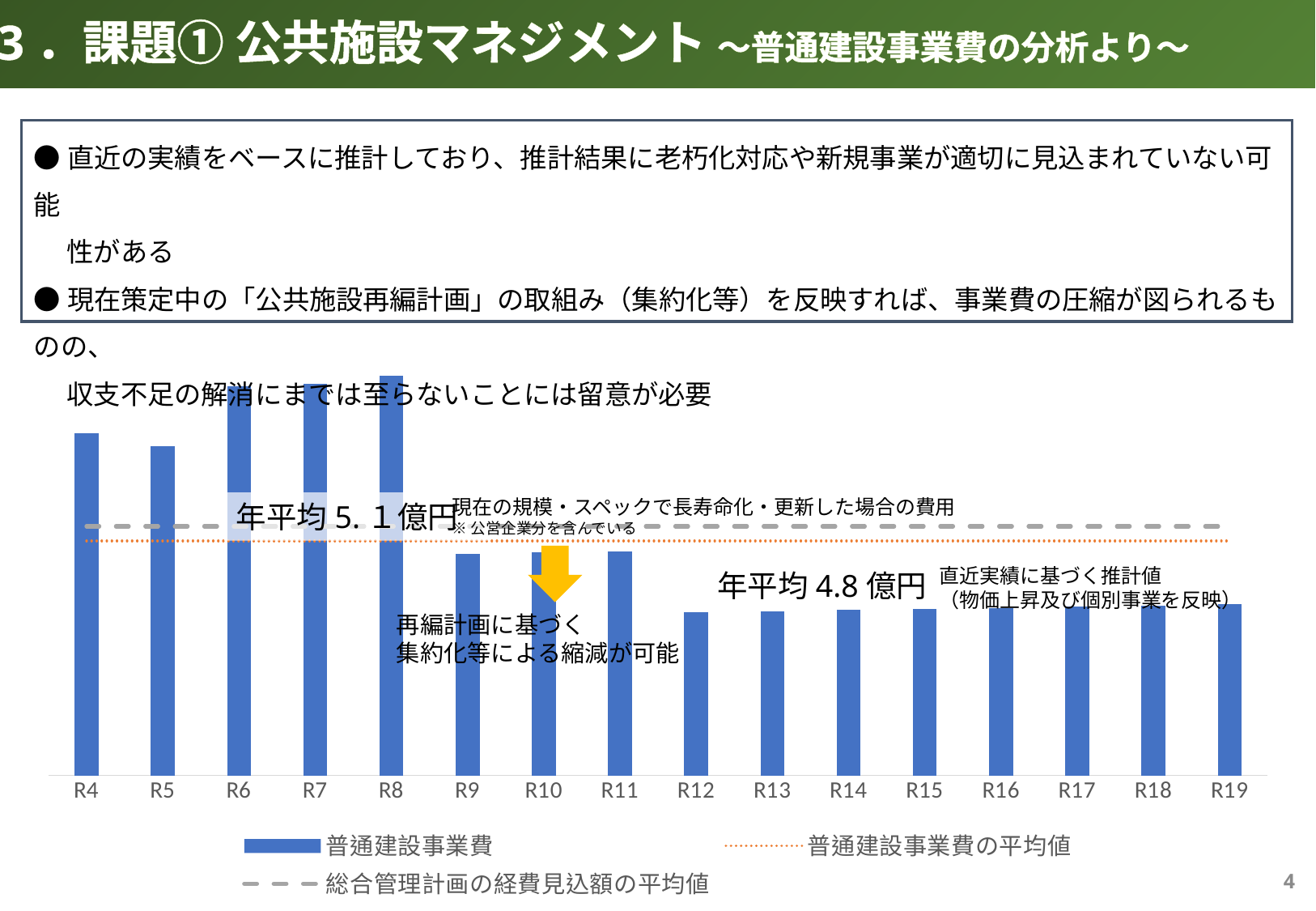
Which is larger, the bar for R9 or the bar for R12? R9 Which average line is higher, 総合管理計画の経費見込額の平均値 or 普通建設事業費の平均値? 総合管理計画の経費見込額の平均値 What annual average value is labelled for 総合管理計画の経費見込額の平均値 (the dashed line)? 5.1億円 How many categories (fiscal years) are shown on the x axis of the chart? 16 How many series does the chart legend list? 3 What is the first category label on the x axis of the chart? R4 Which fiscal year has the highest 普通建設事業費 bar? R8 What annual average value is labelled for 普通建設事業費の平均値 (the dotted line)? 4.8億円 Do the bars rise or fall from R8 to R12? Fall What kind of chart is shown on the slide? Bar chart What is the difference between the two labelled annual averages, 5.1億円 and 4.8億円? 0.3億円 Which is larger, the bar for R4 or the bar for R9? R4